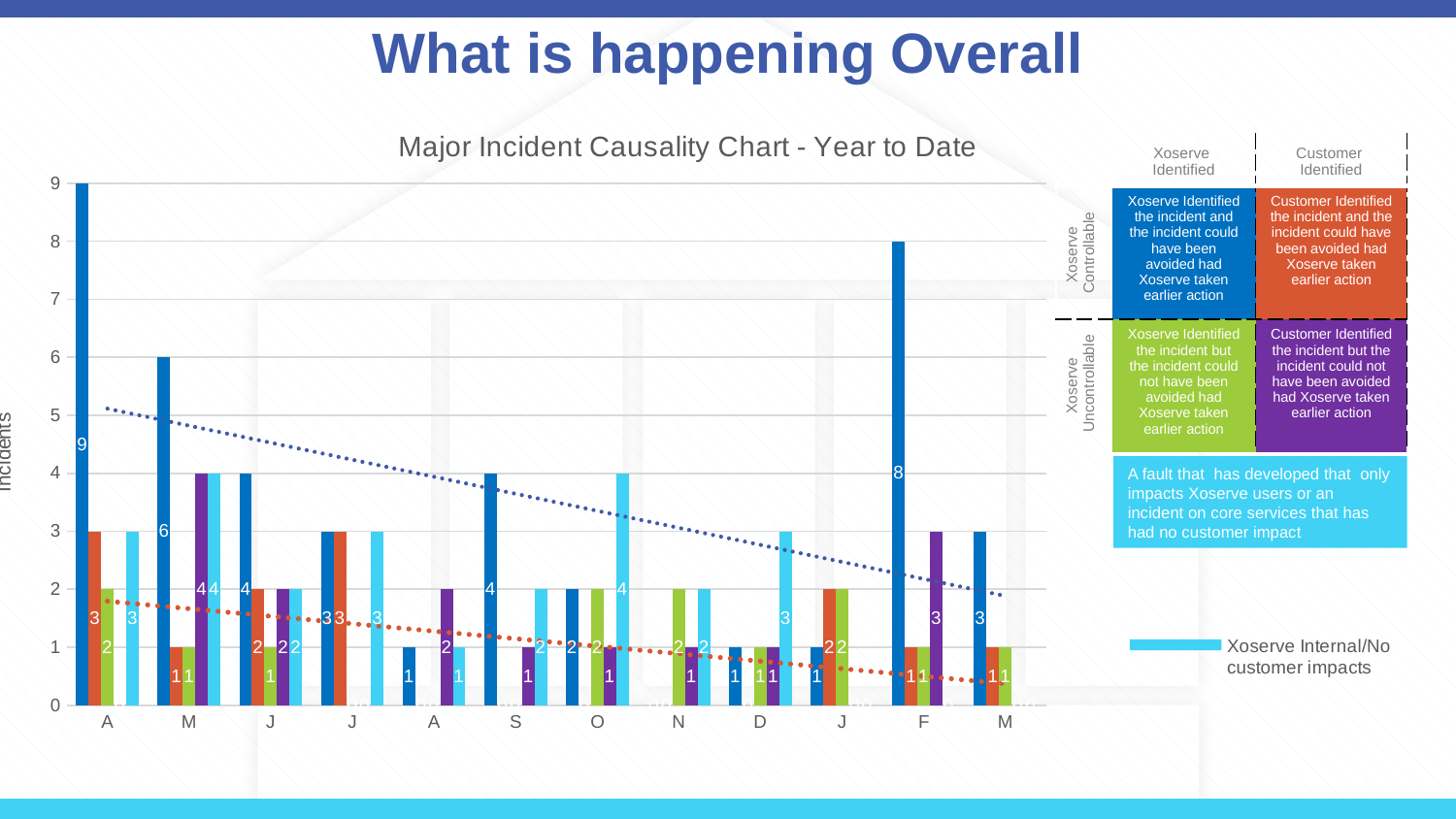
Which is larger: the dark blue bar for the first month (A) or the dark blue bar for M? A Which month has the tallest dark blue bar on the chart? A (the first month) What is the difference between the dark blue bar for the first month (A) and the dark blue bar for F? 1 What is the title of the chart on the slide? Major Incident Causality Chart - Year to Date What is the value of the dark blue bar for the first month (A) on the chart? 9 According to the legend, what do the light blue bars represent? Xoserve Internal/No customer impacts What is the value of the light blue bar for the month O on the chart? 4 What kind of chart is the Major Incident Causality Chart? bar chart Is the value of the dark blue bar for the month M greater or less than 5? greater Does the dotted blue trend line rise or fall from left to right across the chart? fall How many month categories are shown along the x axis of the chart? 12 What is the value of the dark blue bar for the month F on the chart? 8